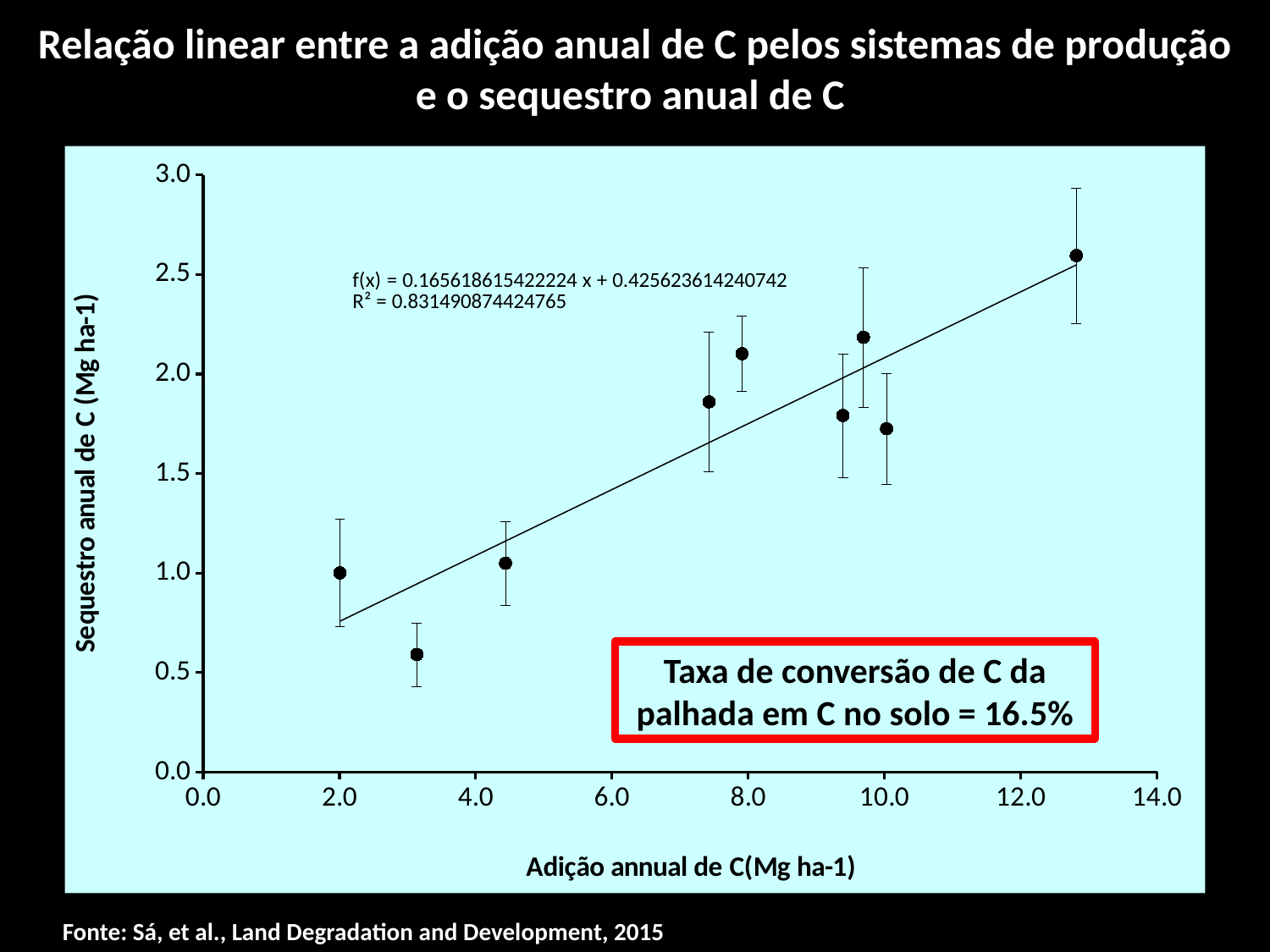
What is the maximum value shown on the x axis? 14.0 What is the title of the y axis? Sequestro anual de C (Mg ha-1) What kind of chart is shown on the slide? Scatter plot What conversion rate of straw C to soil C is stated in the red box on the chart? 16.5% Which point has the highest Sequestro anual de C: the one at about 8.0 on the x axis or the one at about 10.0? The one at about 8.0 Do the values of Sequestro anual de C generally rise or fall as Adição annual de C increases? Rise What is the R² value printed on the chart? 0.831490874424765 What is the slope of the fitted line f(x) shown on the chart? 0.165618615422224 What is the intercept of the fitted line f(x) shown on the chart? 0.425623614240742 How many data points are plotted on the chart? 9 Is the value of Sequestro anual de C for the point at about 3.1 on the x axis greater or less than 1.0? less Is the value of Sequestro anual de C for the point at about 12.8 on the x axis greater or less than 2.5? greater